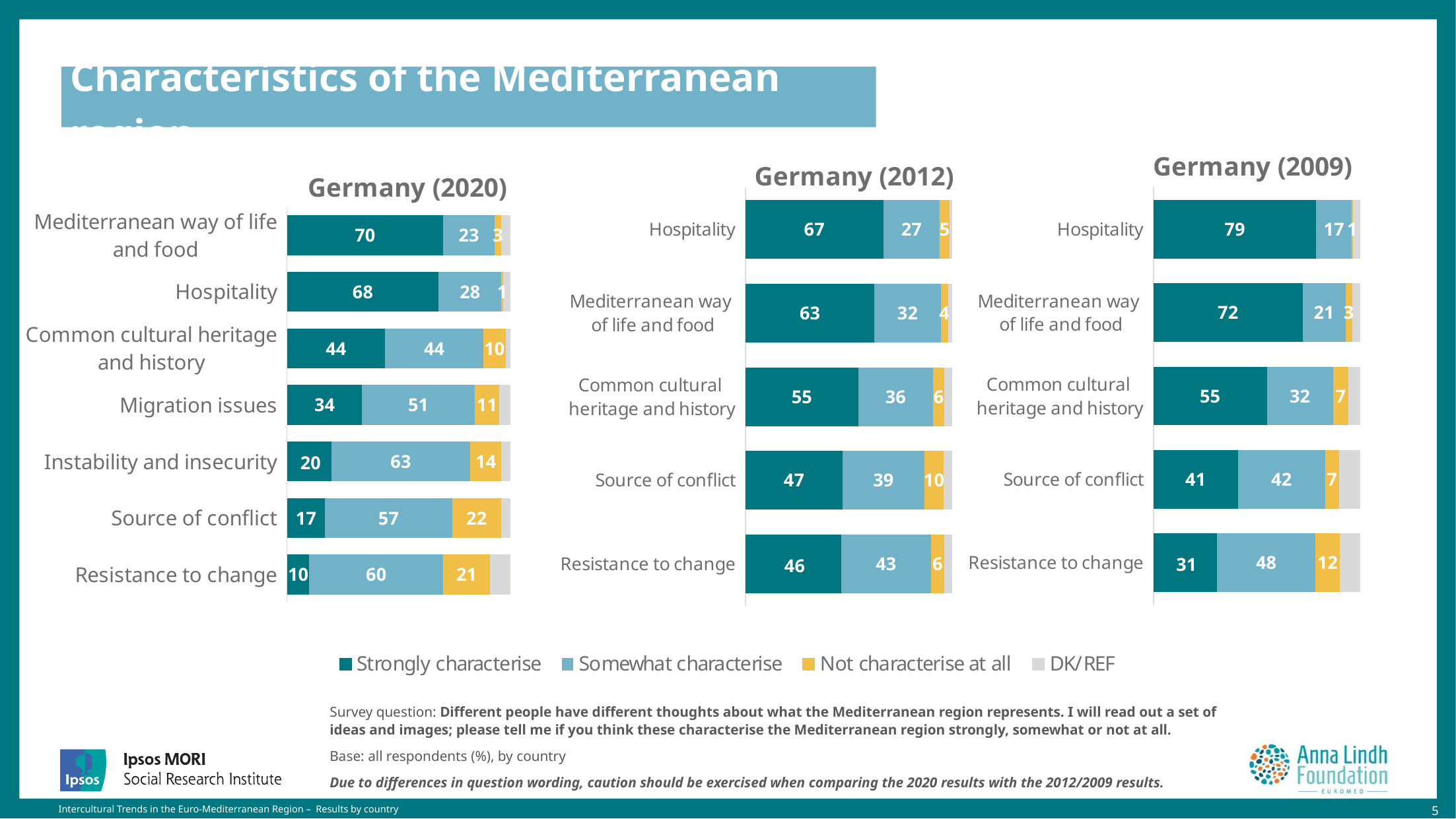
In the Germany (2020) chart, what is the 'Strongly characterise' value for Hospitality? 68 In the Germany (2009) chart, what is the 'Strongly characterise' value for Hospitality? 79 In the Germany (2020) chart, which category has the highest 'Strongly characterise' value? Mediterranean way of life and food In the Germany (2009) chart, how many categories are shown? 5 How many series does the legend list? 4 In the Germany (2020) chart, how many categories are shown? 7 In the Germany (2009) chart, which is larger for Source of conflict: the 'Strongly characterise' value or the 'Somewhat characterise' value? Somewhat characterise In the Germany (2012) chart, what is the 'Somewhat characterise' value for Resistance to change? 43 In the Germany (2020) chart, which category has the lowest 'Strongly characterise' value? Resistance to change What kind of chart is the Germany (2012) chart? Stacked bar chart In the Germany (2020) chart, what is the 'Not characterise at all' value for Source of conflict? 22 In the Germany (2012) chart, what is the difference between the 'Strongly characterise' values for Hospitality and Source of conflict? 20